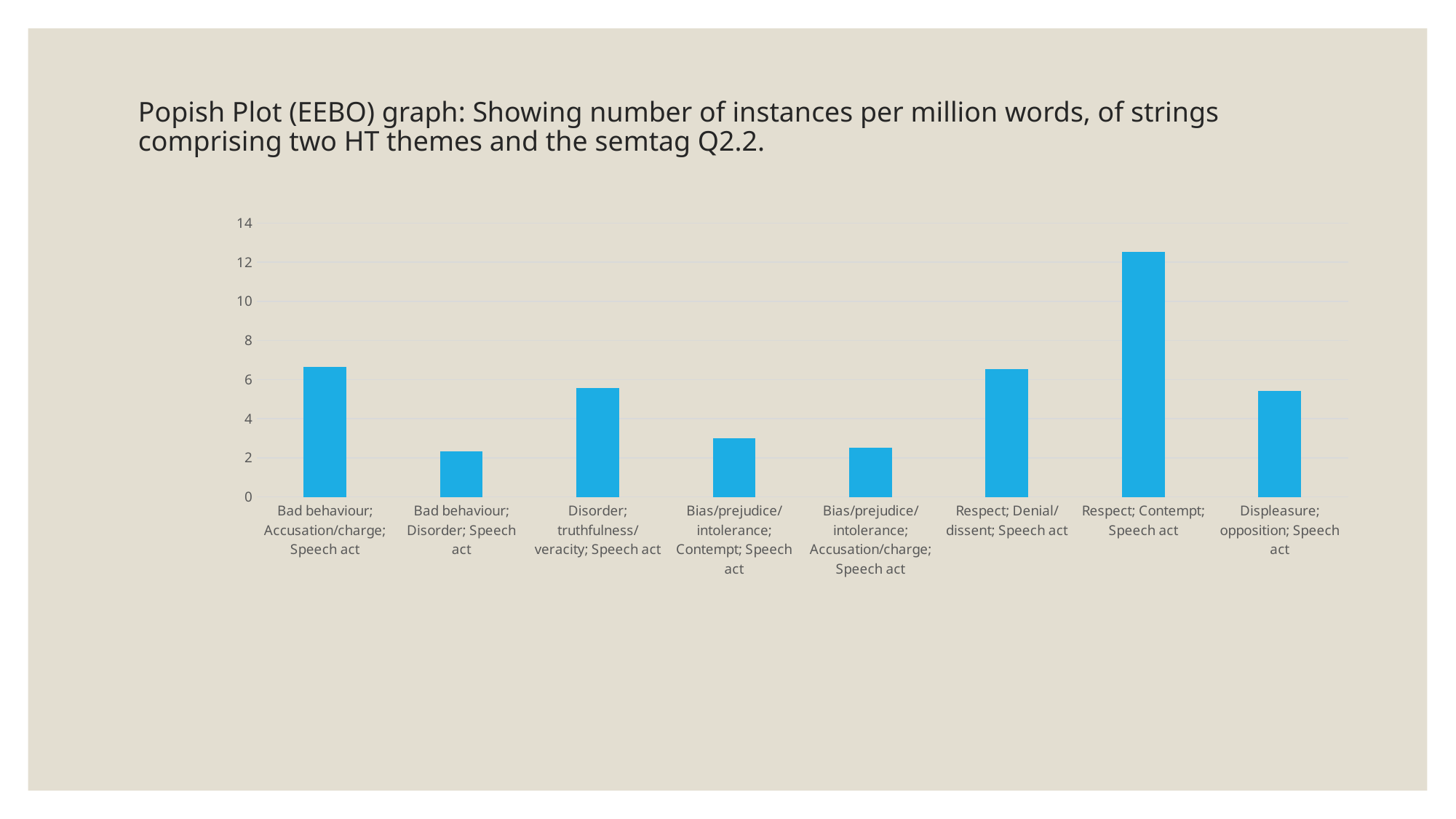
Is the value for Bias/prejudice/intolerance; Contempt; Speech act greater or less than 4? less Is the value for Bad behaviour; Disorder; Speech act greater or less than 4? less How many categories are plotted on the chart? 8 Is the value for Respect; Contempt; Speech act greater or less than 10? greater Which category has the highest value? Respect; Contempt; Speech act What is the highest value shown on the vertical axis? 14 Which is larger: the value for Respect; Contempt; Speech act or the value for Bad behaviour; Accusation/charge; Speech act? Respect; Contempt; Speech act What kind of chart is shown on the slide? bar chart Which is larger: the value for Disorder; truthfulness/veracity; Speech act or the value for Bias/prejudice/intolerance; Contempt; Speech act? Disorder; truthfulness/veracity; Speech act